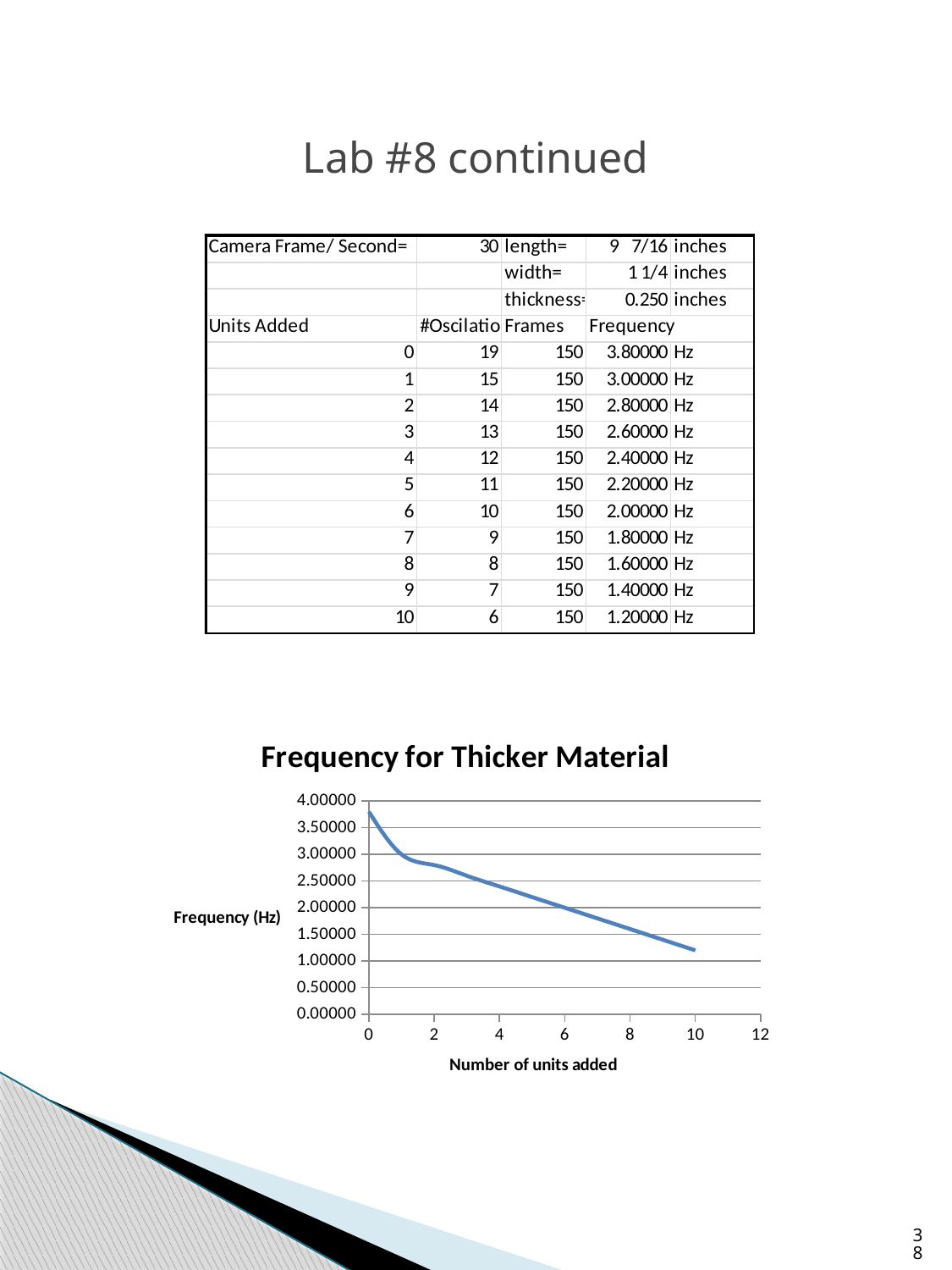
According to the slide, what is the frequency when 6 units are added? 2.00000 Hz According to the slide, what is the frequency when 10 units are added? 1.20000 Hz According to the slide, what is the frequency when 0 units are added? 3.80000 Hz In the chart, is the frequency at 0 units added greater or less than 3.50000? greater What kind of chart is "Frequency for Thicker Material"? line chart What is the x-axis label of the chart? Number of units added At which number of units added is the frequency lowest? 10 At which number of units added is the frequency highest? 0 What is the difference between the frequency at 0 units added and at 10 units added? 2.60000 Hz In the chart, is the frequency at 10 units added greater or less than 1.50000? less What is the title of the chart on the slide? Frequency for Thicker Material In the chart, does the frequency rise or fall as the number of units added increases? fall